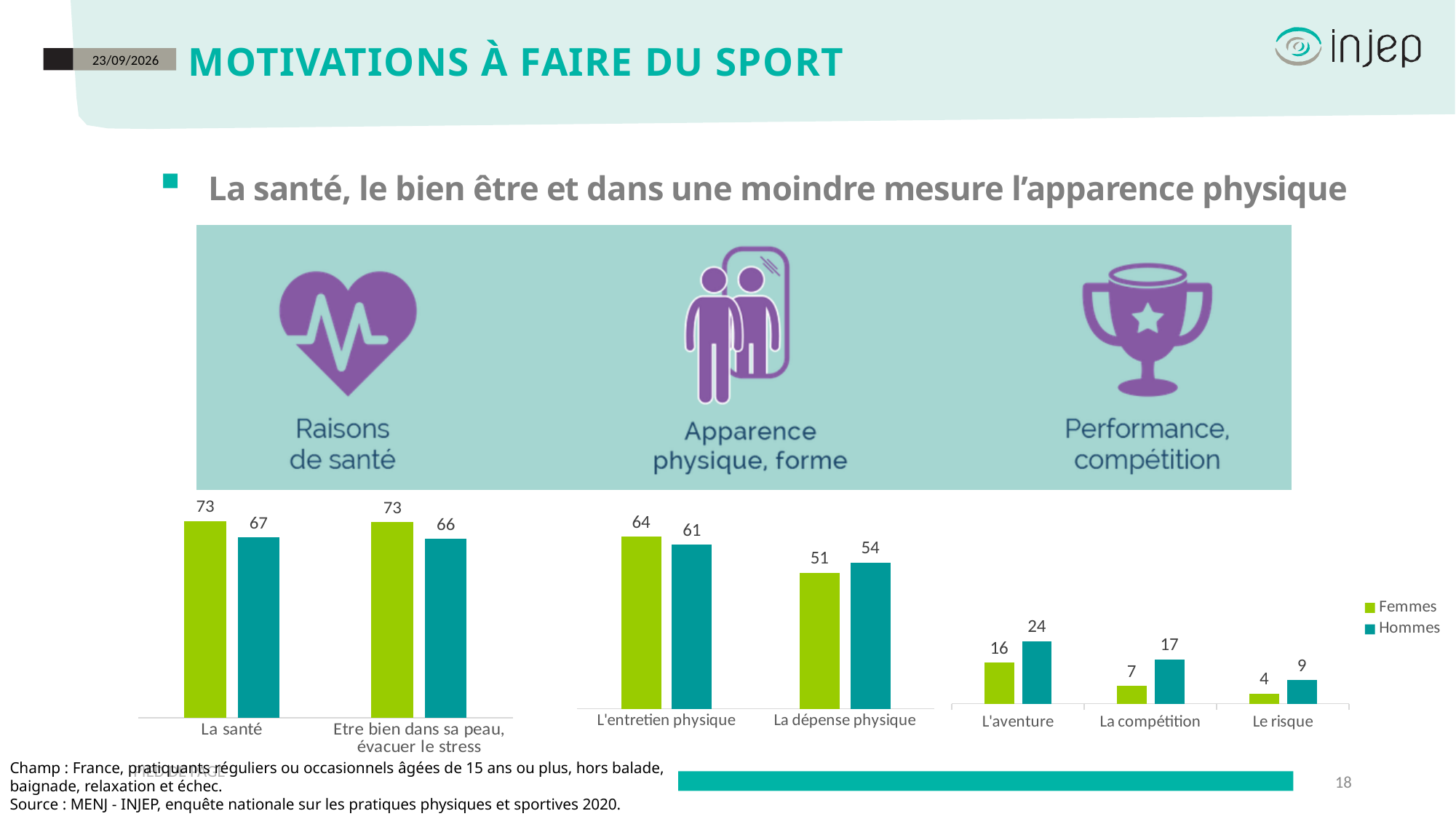
In the right chart (Performance, compétition), what is the difference between the Hommes and Femmes values for 'La compétition'? 10 In the right chart (Performance, compétition), which category has the highest value for Hommes? L'aventure How many categories are shown in the right chart (Performance, compétition)? 3 In the right chart (Performance, compétition), which category has the lowest value for Femmes? Le risque In the left chart (Raisons de santé), what is the value for Hommes for 'Etre bien dans sa peau, évacuer le stress'? 66 How many series does the legend list? 2 In the right chart (Performance, compétition), what is the value for Femmes for 'La compétition'? 7 In the left chart (Raisons de santé), what is the value for Femmes for 'La santé'? 73 What kind of chart is used on this slide? Bar chart In the middle chart (Apparence physique, forme), which is larger for 'La dépense physique': the Femmes value or the Hommes value? Hommes In the middle chart (Apparence physique, forme), what is the difference between the Femmes and Hommes values for 'L'entretien physique'? 3 In the middle chart (Apparence physique, forme), what is the value for Hommes for 'La dépense physique'? 54